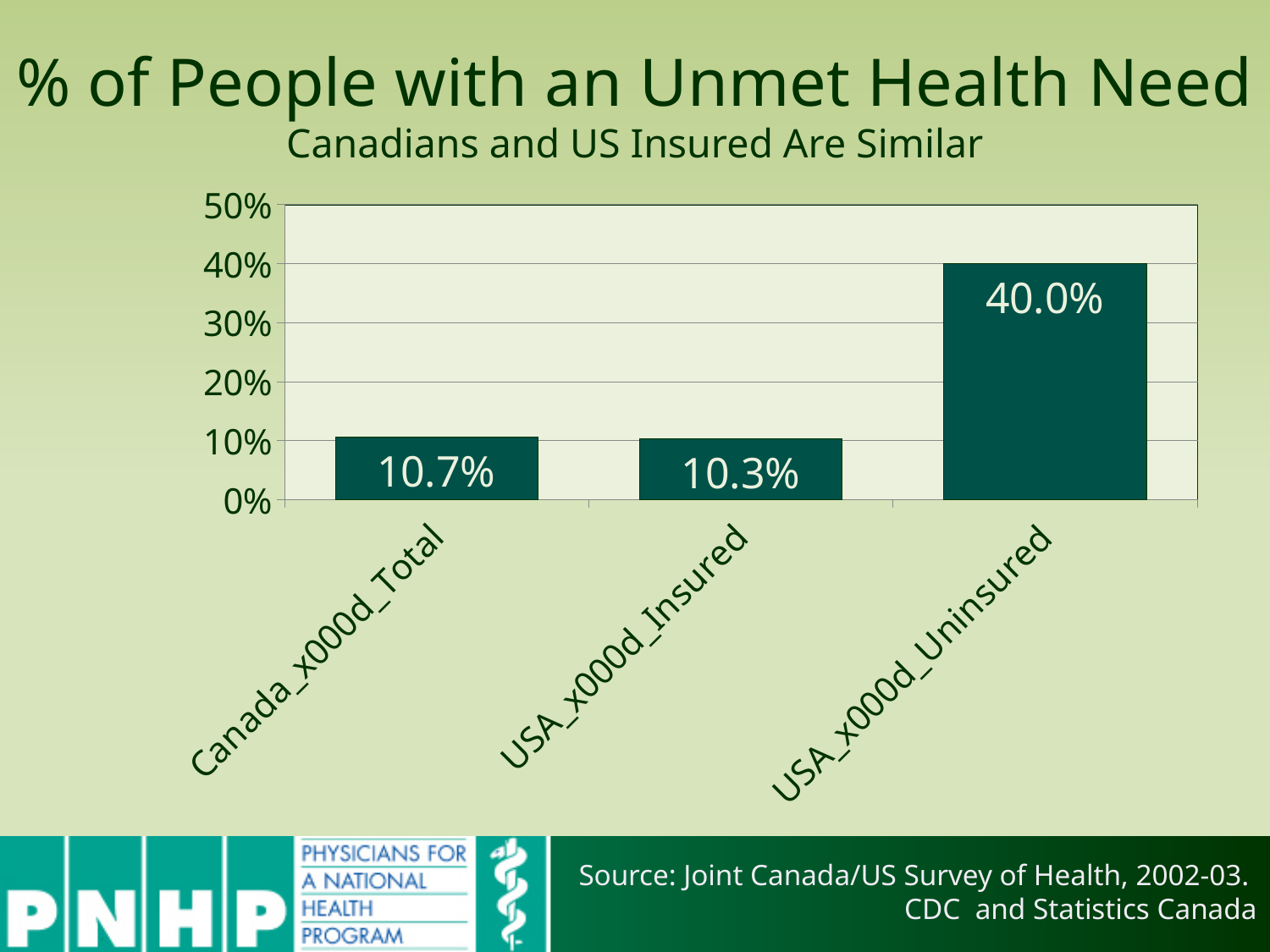
Which category has the highest value? USA_x000d_Uninsured Which is larger, the value for Canada_x000d_Total or the value for USA_x000d_Insured? Canada_x000d_Total What is the title of the chart on the slide? % of People with an Unmet Health Need Which category has the lowest value? USA_x000d_Insured What is the value for Canada_x000d_Total? 10.7% What kind of chart is shown on the slide? bar chart What is the value for USA_x000d_Insured? 10.3% What is the value for USA_x000d_Uninsured? 40.0% What is the difference between the values for USA_x000d_Uninsured and Canada_x000d_Total? 29.3 percentage points What is the difference between the values for Canada_x000d_Total and USA_x000d_Insured? 0.4 percentage points How many categories are shown on the chart? 3 Is the value for USA_x000d_Uninsured greater or less than 30%? greater